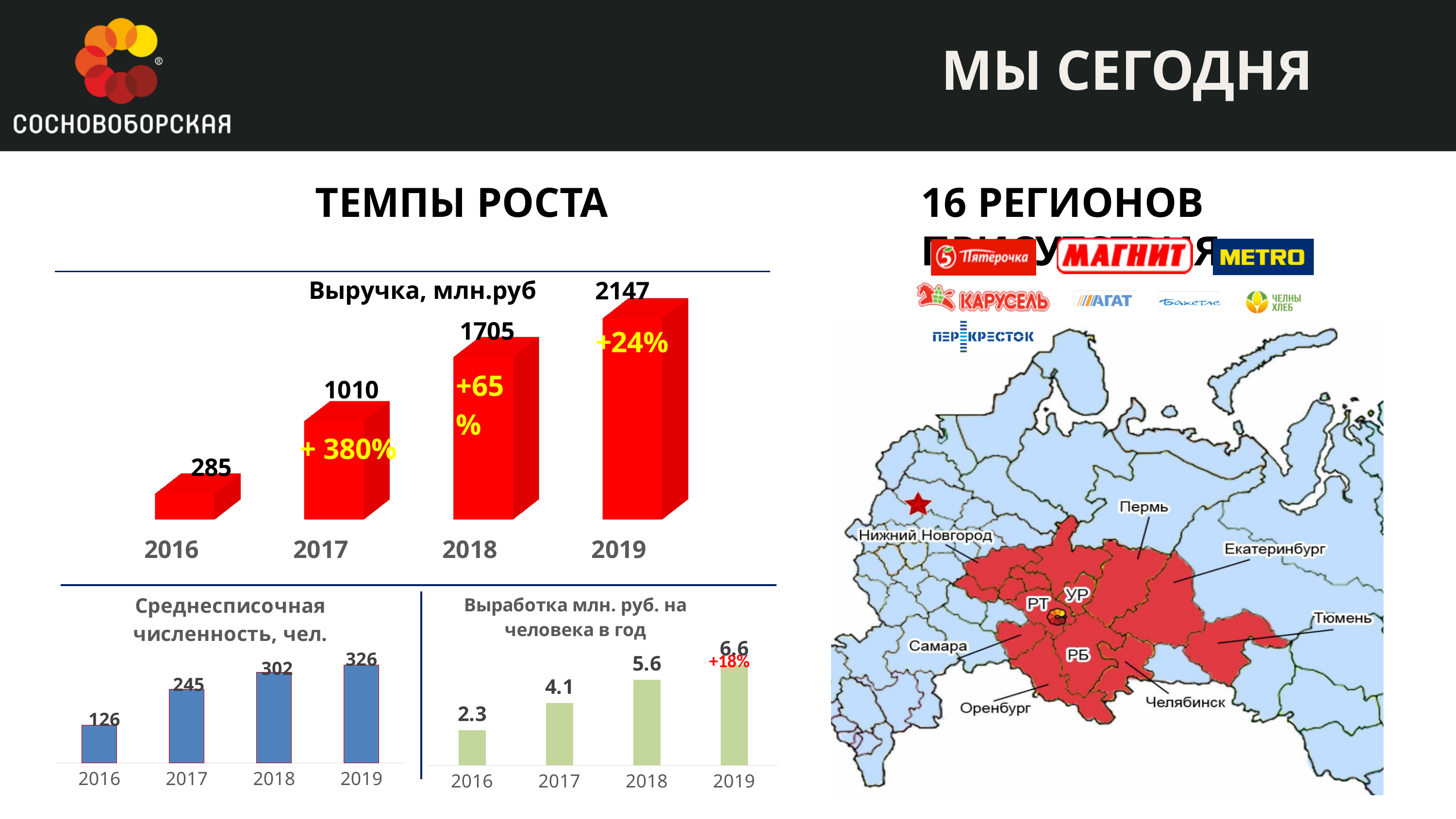
In the "Выручка, млн.руб" chart, what is the value for 2019? 2147 In the "Выручка, млн.руб" chart, what is the difference between the 2018 and 2017 values? 695 In the "Выручка, млн.руб" chart, what percentage growth is labelled on the 2019 bar? +24% How many years are shown in the "Выработка млн. руб. на человека в год" chart? 4 In the "Выработка млн. руб. на человека в год" chart, do the values rise or fall from 2016 to 2019? rise What type of chart is the "Среднесписочная численность, чел." chart? bar chart In the "Среднесписочная численность, чел." chart, what is the difference between the 2019 and 2016 values? 200 In the "Выручка, млн.руб" chart, which year has the lowest value? 2016 In the "Выручка, млн.руб" chart, what is the value for 2016? 285 In the "Среднесписочная численность, чел." chart, which year has the highest value? 2019 In the "Выработка млн. руб. на человека в год" chart, what is the value for 2018? 5.6 In the "Среднесписочная численность, чел." chart, what is the value for 2017? 245